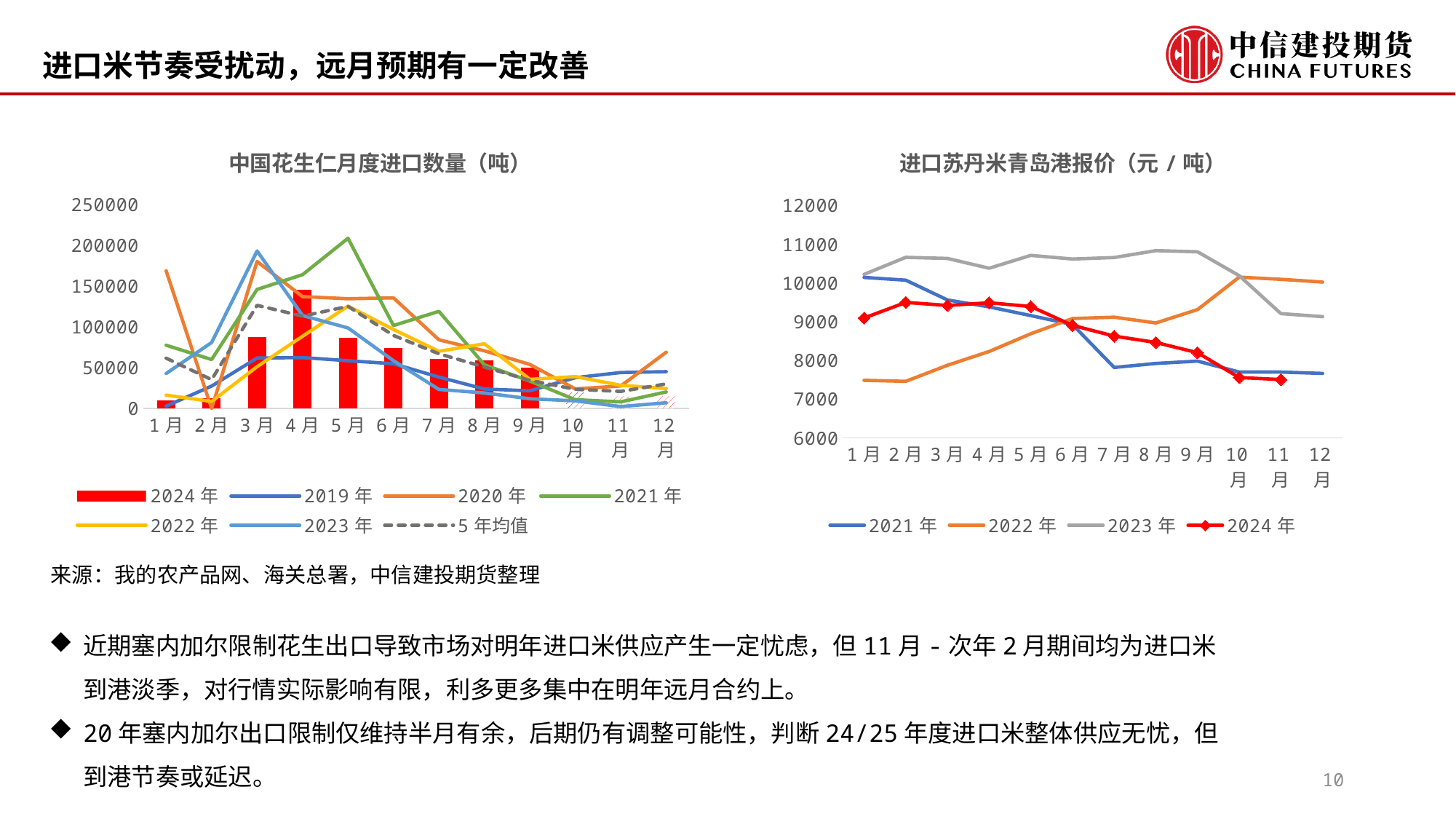
How many months are shown on the x axis of the right chart (进口苏丹米青岛港报价)? 12 In the left chart (中国花生仁月度进口数量), which series is drawn as bars? 2024年 In the left chart (中国花生仁月度进口数量), in which month is the 2024年 bar highest? 4月 In the right chart (进口苏丹米青岛港报价), which series has the highest value in 9月? 2023年 In the right chart (进口苏丹米青岛港报价), does the 2024年 line rise or fall from 1月 to 11月? fall What type of chart is the left chart titled 中国花生仁月度进口数量（吨）? Combined bar and line chart In the left chart (中国花生仁月度进口数量), which is larger, the 2024年 bar for 4月 or for 9月? 4月 In the right chart (进口苏丹米青岛港报价), is the 2024年 value for 11月 greater or less than 8000? less How many series does the legend of the left chart (中国花生仁月度进口数量) list? 7 In the left chart (中国花生仁月度进口数量), is the 2024年 value for 4月 greater or less than 100000? greater How many series does the legend of the right chart (进口苏丹米青岛港报价) list? 4 In the left chart (中国花生仁月度进口数量), is the 2021年 value for 5月 greater or less than 200000? greater